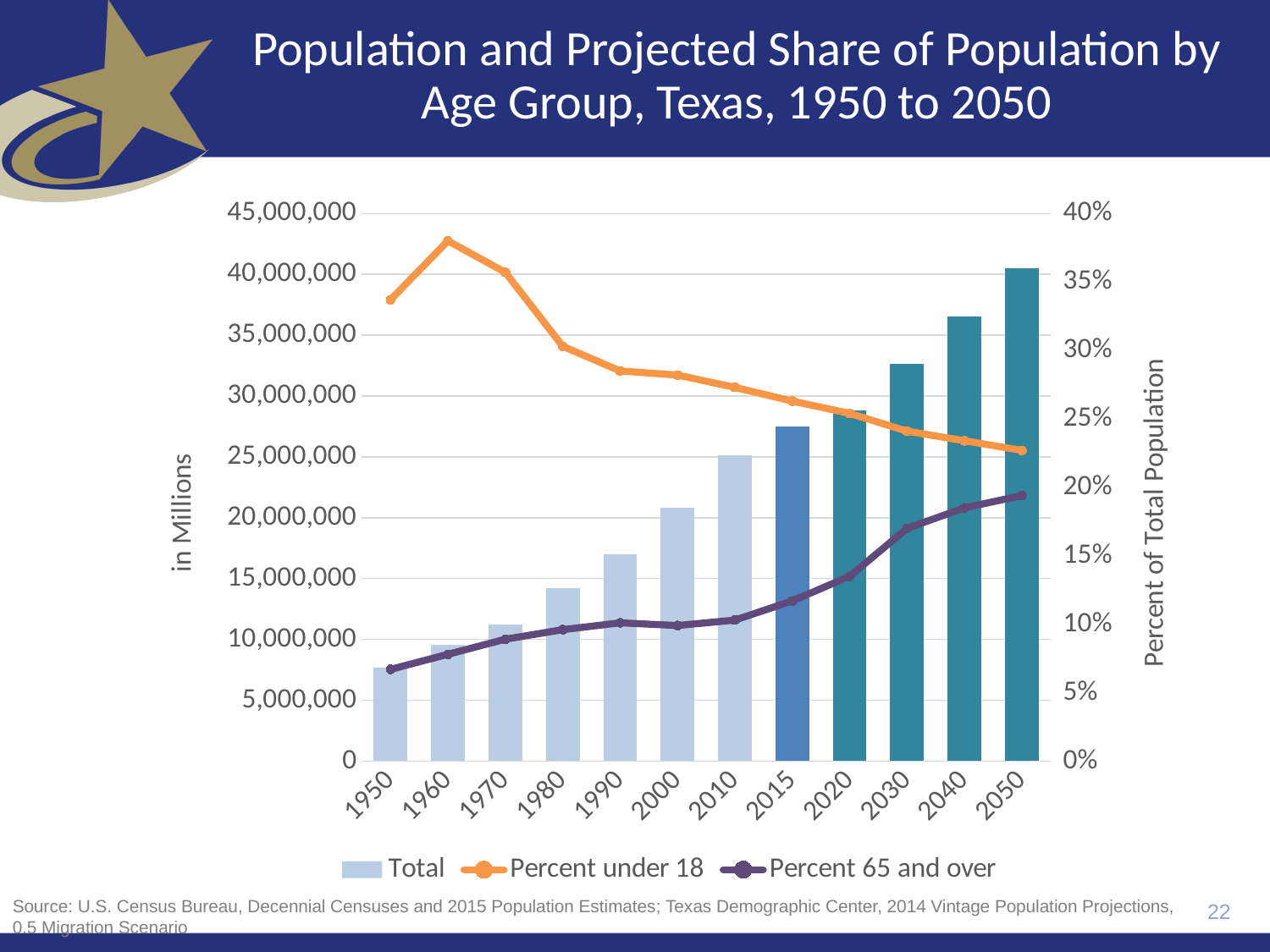
In which year is the Total population bar the lowest? 1950 In which year does the Percent under 18 line reach its highest point? 1960 Is the Percent under 18 value for 1960 greater or less than 35%? greater In which year is the Total population bar the highest? 2050 How many years are shown along the x axis? 12 What kind of chart is shown on the slide? A combination bar and line chart Is the Total population value for 2050 greater or less than 35,000,000? greater Is the Total population value for 1950 greater or less than 10,000,000? less In 2050, which is larger: Percent under 18 or Percent 65 and over? Percent under 18 How many series does the legend list? 3 In which year is the Percent 65 and over line at its lowest? 1950 Do the Total population bars rise or fall from 1950 to 2050? rise